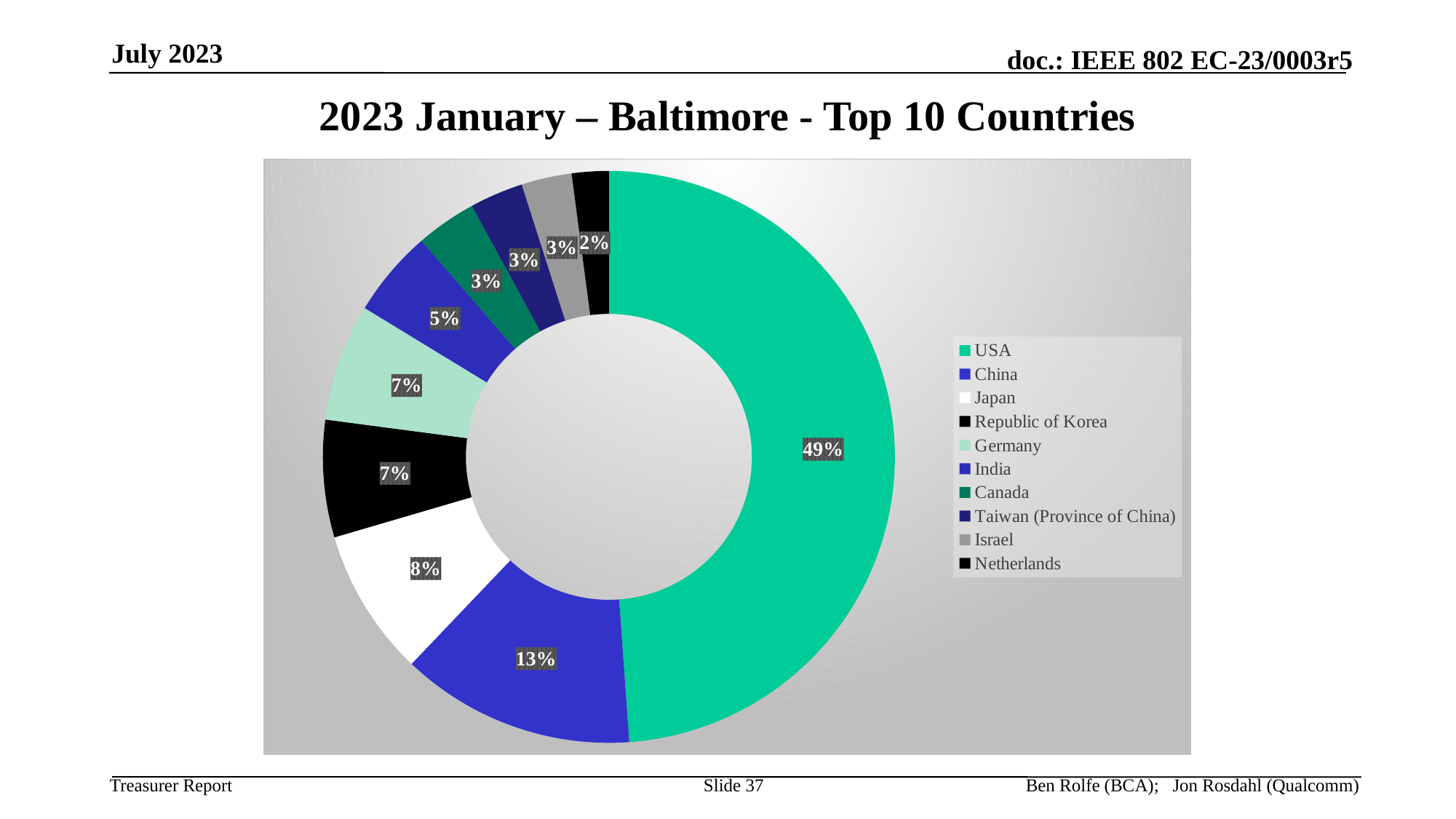
What percentage is shown for Japan? 8% What is the difference in percentage points between USA and China? 36 What percentage is shown for Netherlands? 2% Which country has the smallest share in the chart? Netherlands What percentage is shown for China? 13% What share of the chart does USA account for? 49% What percentage is shown for India? 5% What kind of chart is shown on the slide? doughnut chart What is the title of the chart on the slide? 2023 January – Baltimore - Top 10 Countries Which country has the largest share in the chart? USA How many countries are listed in the legend? 10 Which has a larger share, Japan or India? Japan